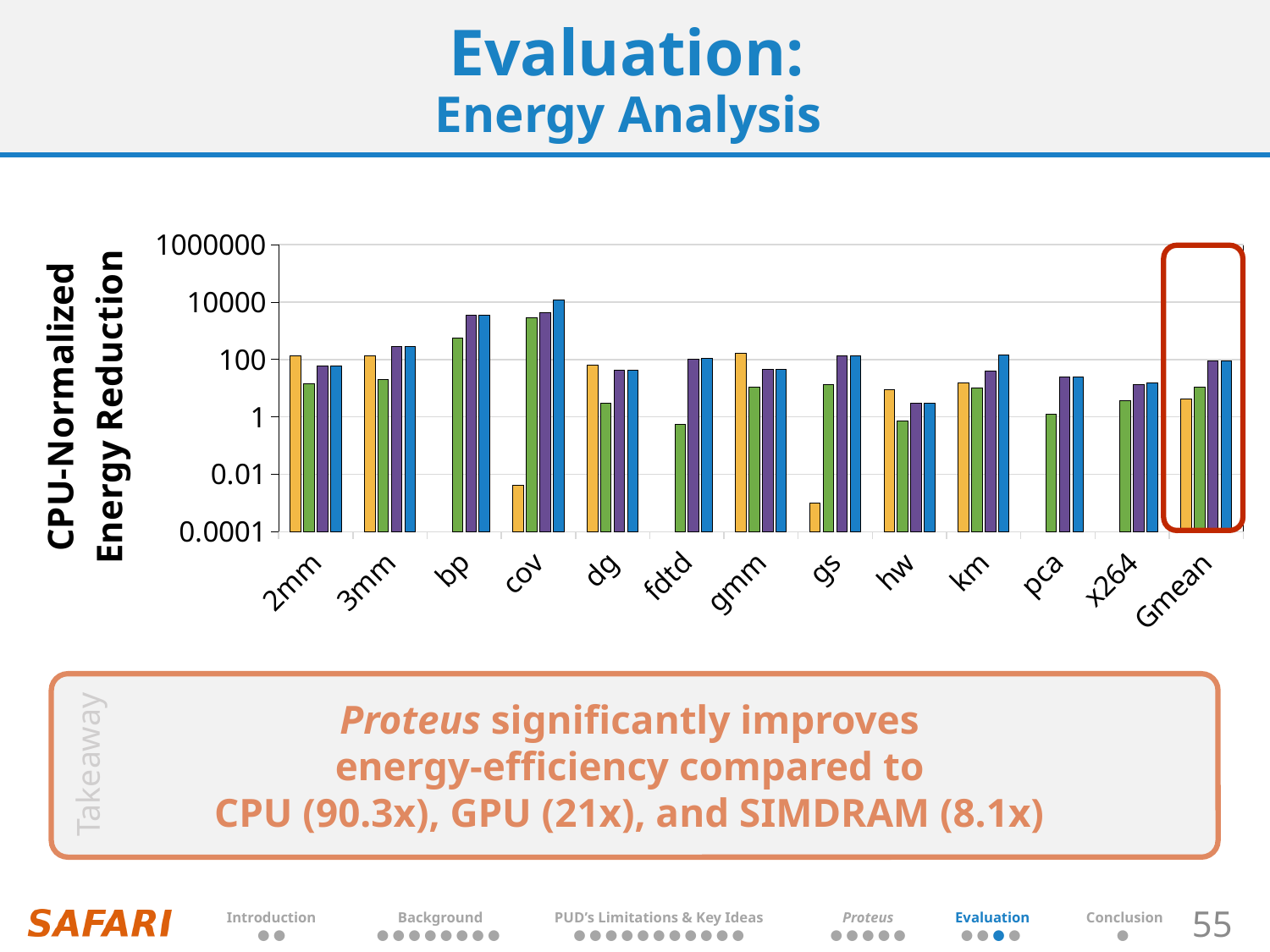
What is the title of the y axis of the chart? CPU-Normalized Energy Reduction Is the green bar for fdtd greater or less than 1? less Is the yellow bar for cov greater or less than 1? less Which category contains the shortest bar in the chart? gs Which category on the x axis is highlighted with a red box? Gmean Which category contains the tallest bar in the chart? cov How many categories are shown along the x axis of the chart? 13 Which is larger, the yellow bar for 2mm or the yellow bar for cov? the yellow bar for 2mm Which is larger, the blue bar for bp or the blue bar for 2mm? the blue bar for bp What kind of chart is shown on the slide? bar chart Is the yellow bar for hw greater or less than 100? less